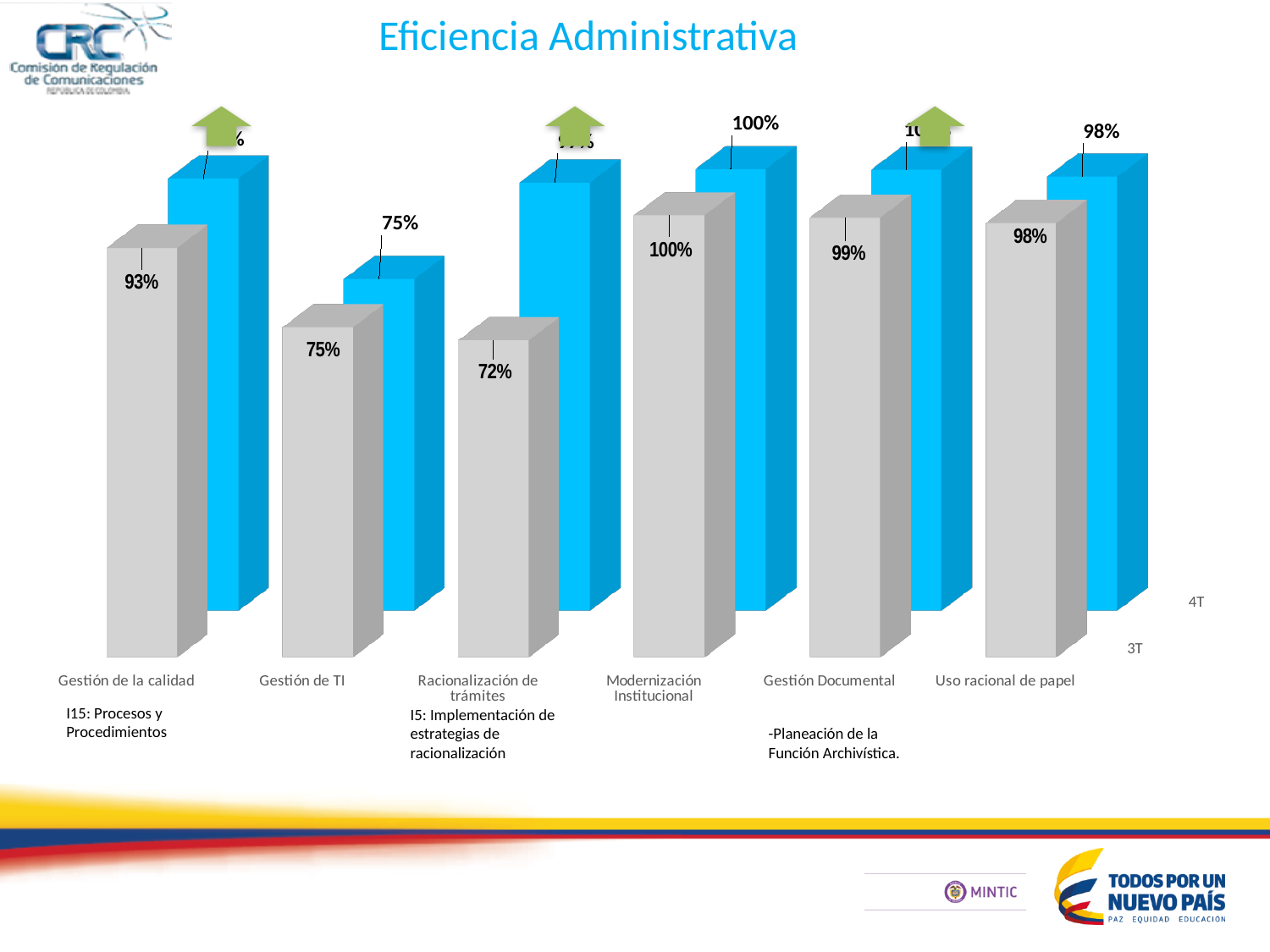
Which category has the lowest 3T value? Racionalización de trámites What kind of chart is shown on the slide? bar chart What is the title of the chart on the slide? Eficiencia Administrativa What is the 3T value for Racionalización de trámites? 72% What is the difference between the 3T values for Gestión de la calidad and Racionalización de trámites? 21% What is the 4T value for Gestión de TI? 75% How many categories are shown along the x axis of the chart? 6 What is the 3T value for Gestión Documental? 99% How many series does the chart show? 2 What is the 4T value for Modernización Institucional? 100% What is the 3T value for Gestión de la calidad? 93% What is the 4T value for Uso racional de papel? 98%